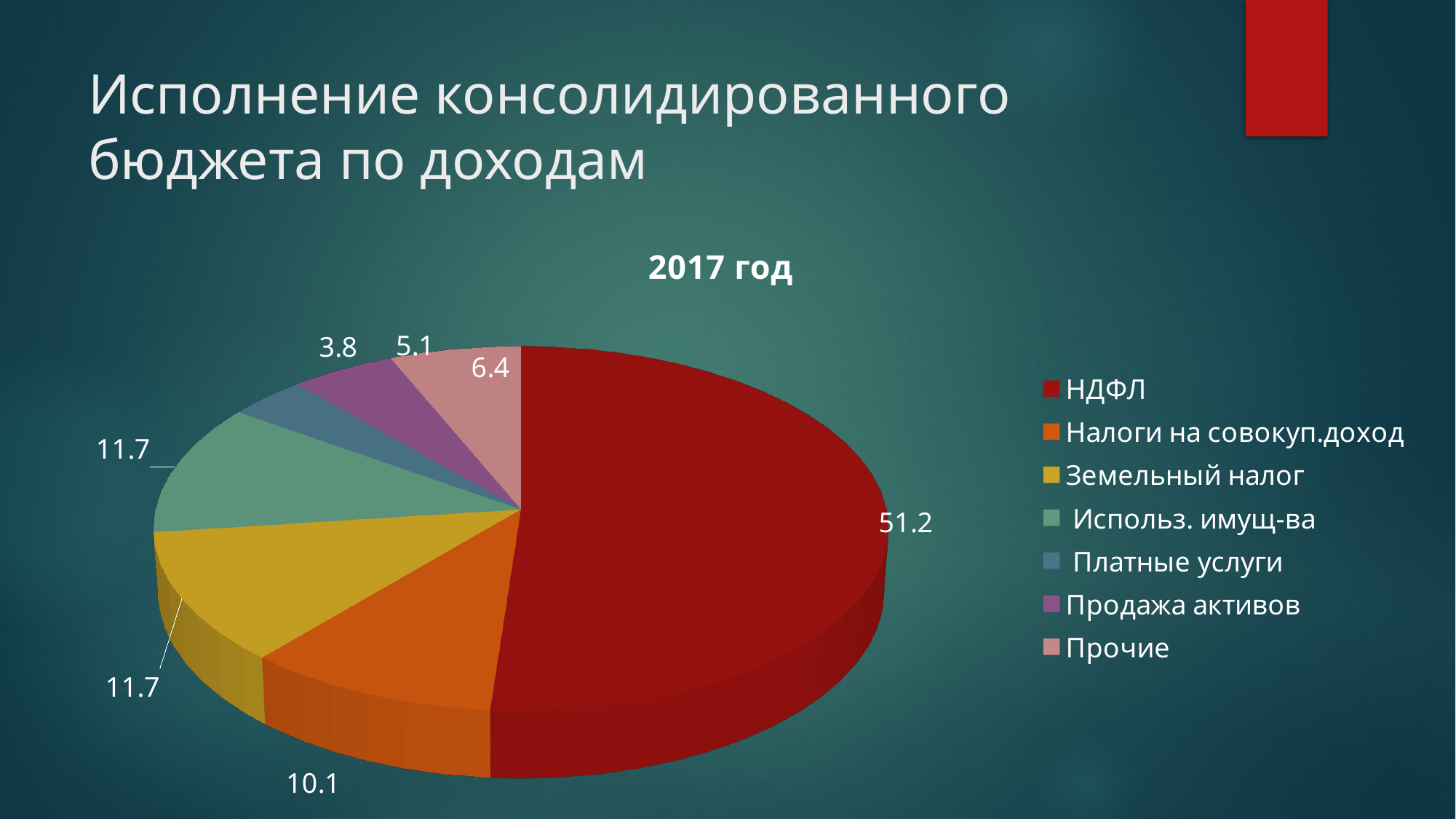
How many entries does the legend list? 7 Which category has the smallest slice of the pie? Платные услуги What is the value for Налоги на совокуп.доход? 10.1 Which is larger, the value for Продажа активов or the value for Прочие? Прочие What kind of chart is shown on the slide? pie chart What is the title of the chart? 2017 год What is the value for Прочие? 6.4 What is the value for Платные услуги? 3.8 What is the difference between the values for НДФЛ and Земельный налог? 39.5 How many slices does the pie chart have? 7 What is the value for НДФЛ? 51.2 Which category has the largest slice of the pie? НДФЛ